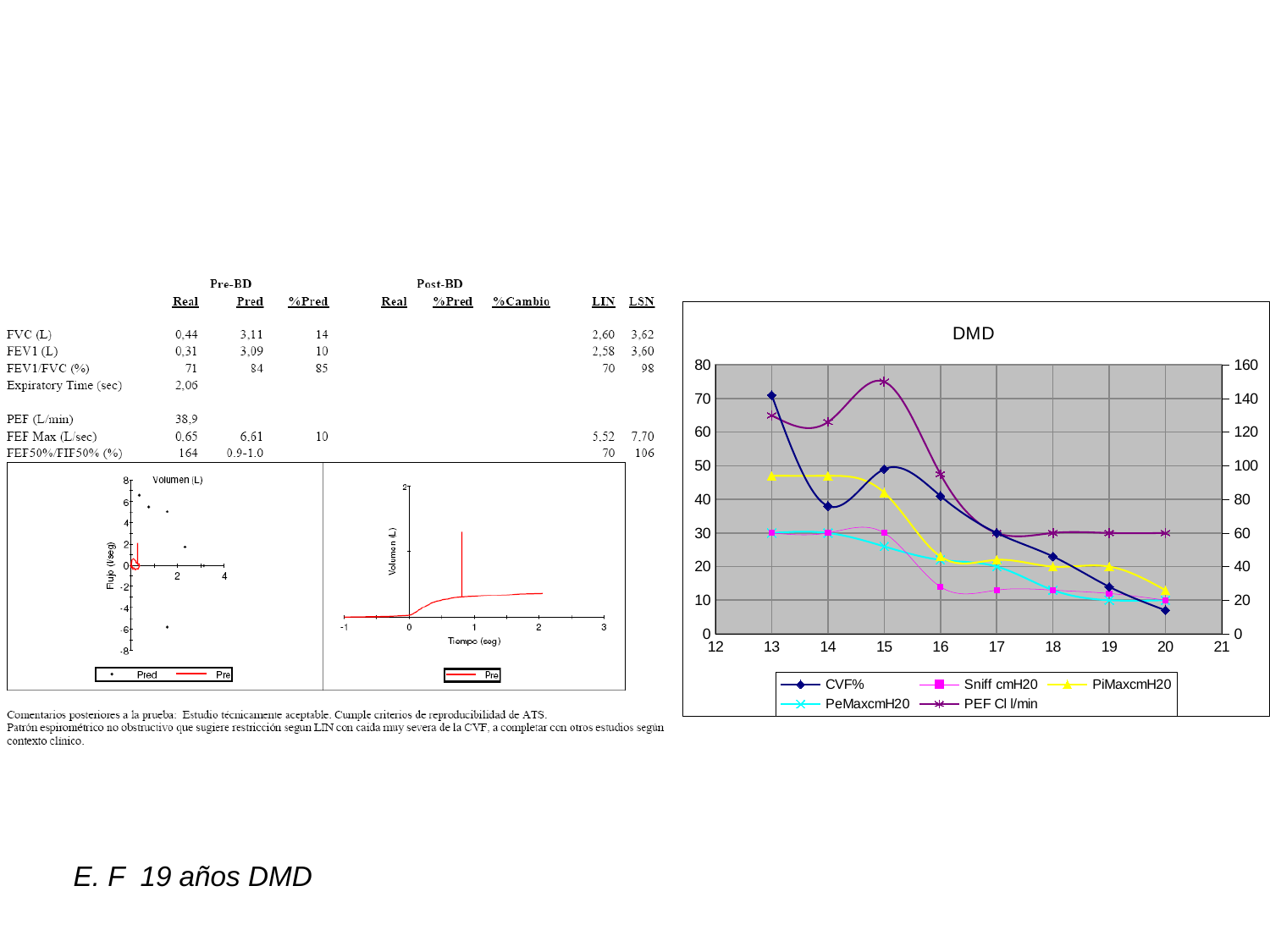
What is the title of the line chart on the right side of the slide? DMD In the chart titled DMD, is the PiMaxcmH20 value at 13 greater or less than 40? greater In the chart titled DMD, how many data points does the CVF% series have? 8 In the chart titled DMD, what kind of chart is it? line chart In the chart titled DMD, at which x-axis value is CVF% highest? 13 In the chart titled DMD, at x = 13, which is larger on the left axis: CVF% or PiMaxcmH20? CVF% In the chart titled DMD, at which x-axis value is CVF% lowest? 20 In the chart titled DMD, is the CVF% value at 13 greater or less than 60? greater In the chart titled DMD, is the Sniff cmH20 value at 16 greater or less than 20? less In the chart titled DMD, how many series does the legend list? 5 In the chart titled DMD, does the CVF% series rise or fall overall from 13 to 20? fall